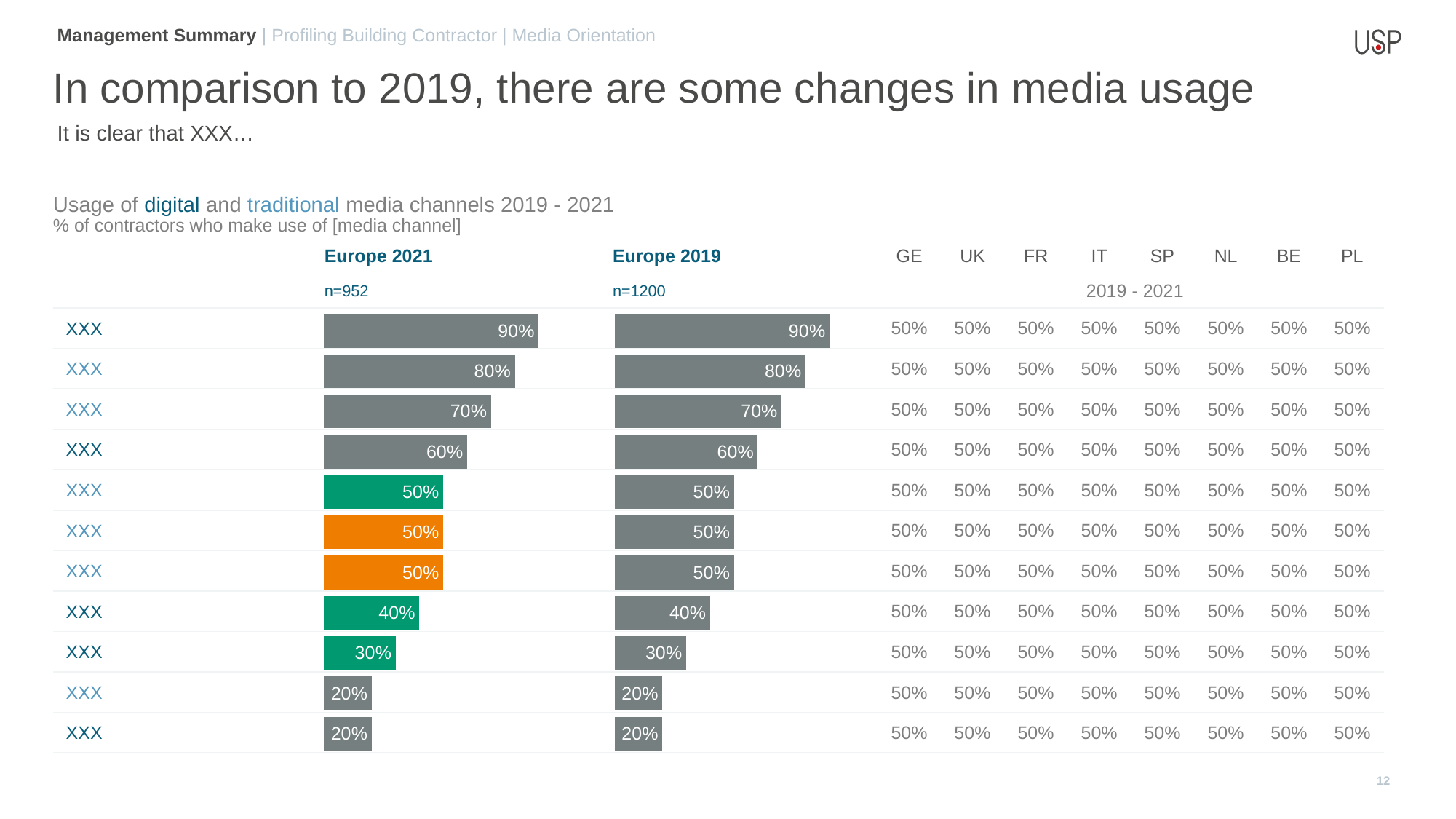
How many bars are plotted in the Europe 2021 chart? 11 In the Europe 2019 chart, what is the value of the top bar? 90% What is the sample size (n) shown for the Europe 2021 chart? n=952 In the Europe 2021 chart, what is the value of the fourth bar from the top? 60% In the Europe 2021 chart, which is larger: the top bar or the fourth bar from the top? the top bar In the Europe 2021 chart, what is the difference between the top bar (90%) and the bottom bar (20%)? 70 percentage points In the Europe 2021 chart, what is the highest value shown? 90% What kind of chart is used for the Europe 2021 column? bar chart In the Europe 2021 chart, what is the lowest value shown? 20% How many bars in the Europe 2021 chart are coloured green? 3 What is the sample size (n) shown for the Europe 2019 chart? n=1200 In the Europe 2021 chart, do the bar values rise or fall going from the top row to the bottom row? fall